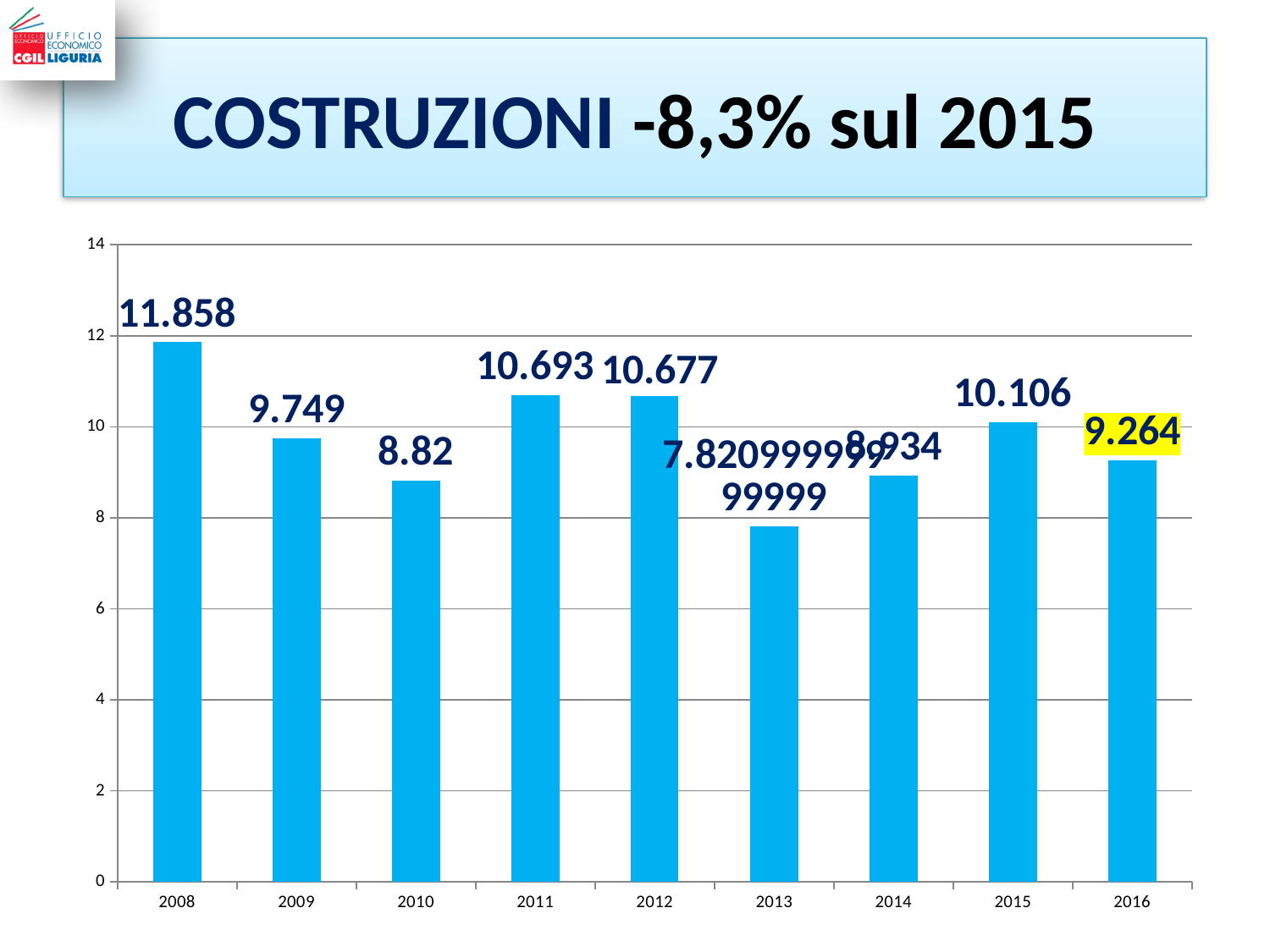
Which is larger, the value for 2015 or the value for 2016? 2015 What is the value for 2010? 8.82 What is the difference between the values for 2015 and 2016? 0.842 How many years are shown on the x axis? 9 Is the value for 2013 greater or less than 8? less What is the value for 2008? 11.858 What kind of chart is shown on the slide? bar chart Which year has the lowest value? 2013 What is the value for 2016? 9.264 What is the value for 2011? 10.693 Which year has the highest value? 2008 What is the difference between the values for 2008 and 2009? 2.109